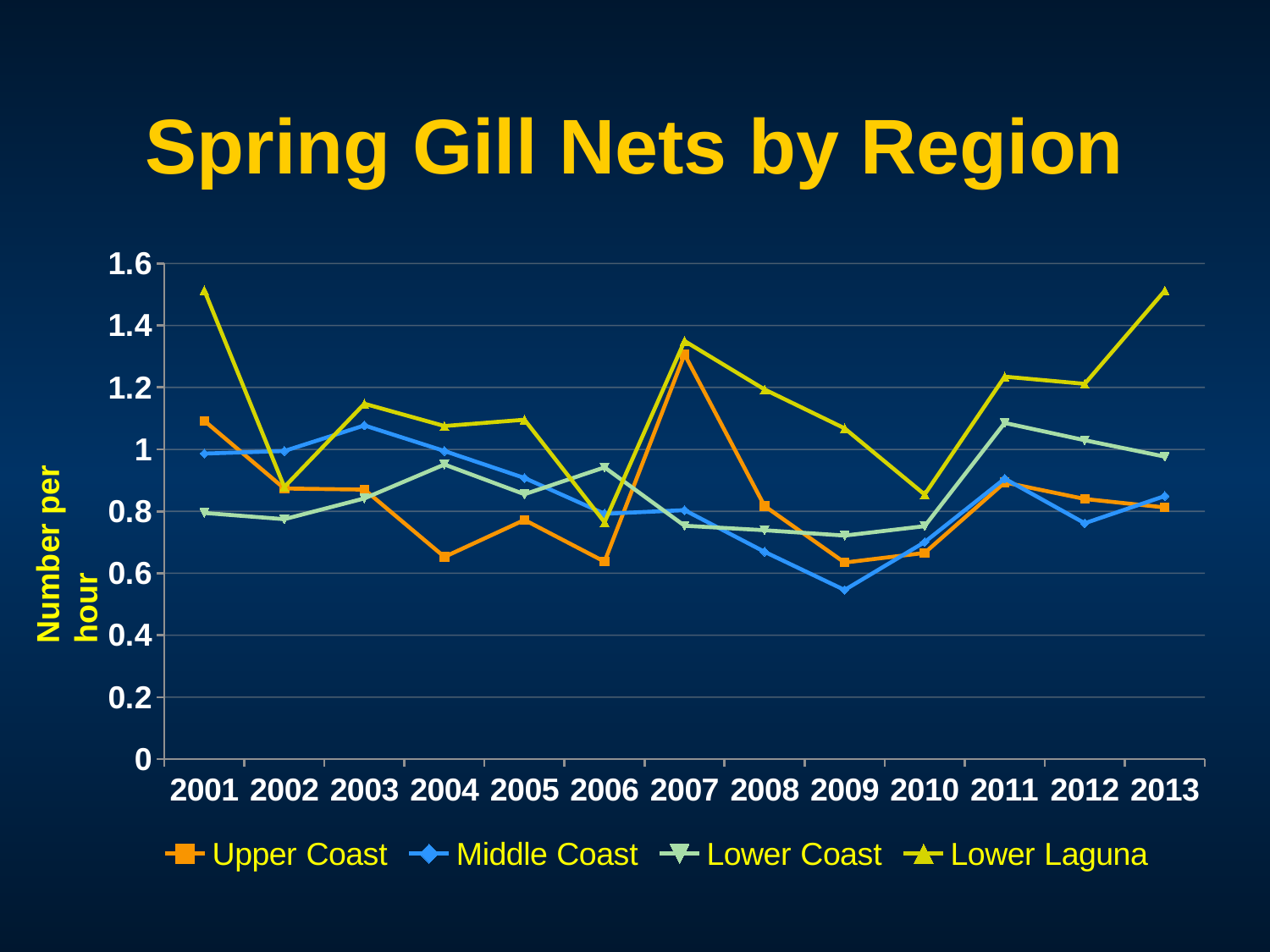
Is the value for Lower Laguna in 2001 greater or less than 1.4? greater What kind of chart is shown on the slide? line chart Does the Lower Laguna line rise or fall from 2010 to 2013? rise Is the value for Middle Coast in 2009 greater or less than 0.6? less Which region has the lowest value in 2009? Middle Coast What is the title of the chart? Spring Gill Nets by Region What is the label on the vertical axis? Number per hour In 2007, which is larger: the value for Upper Coast or the value for Middle Coast? Upper Coast How many years are shown along the x axis? 13 Which region has the highest value in 2013? Lower Laguna Is the value for Upper Coast in 2004 greater or less than 0.8? less How many series does the legend list? 4